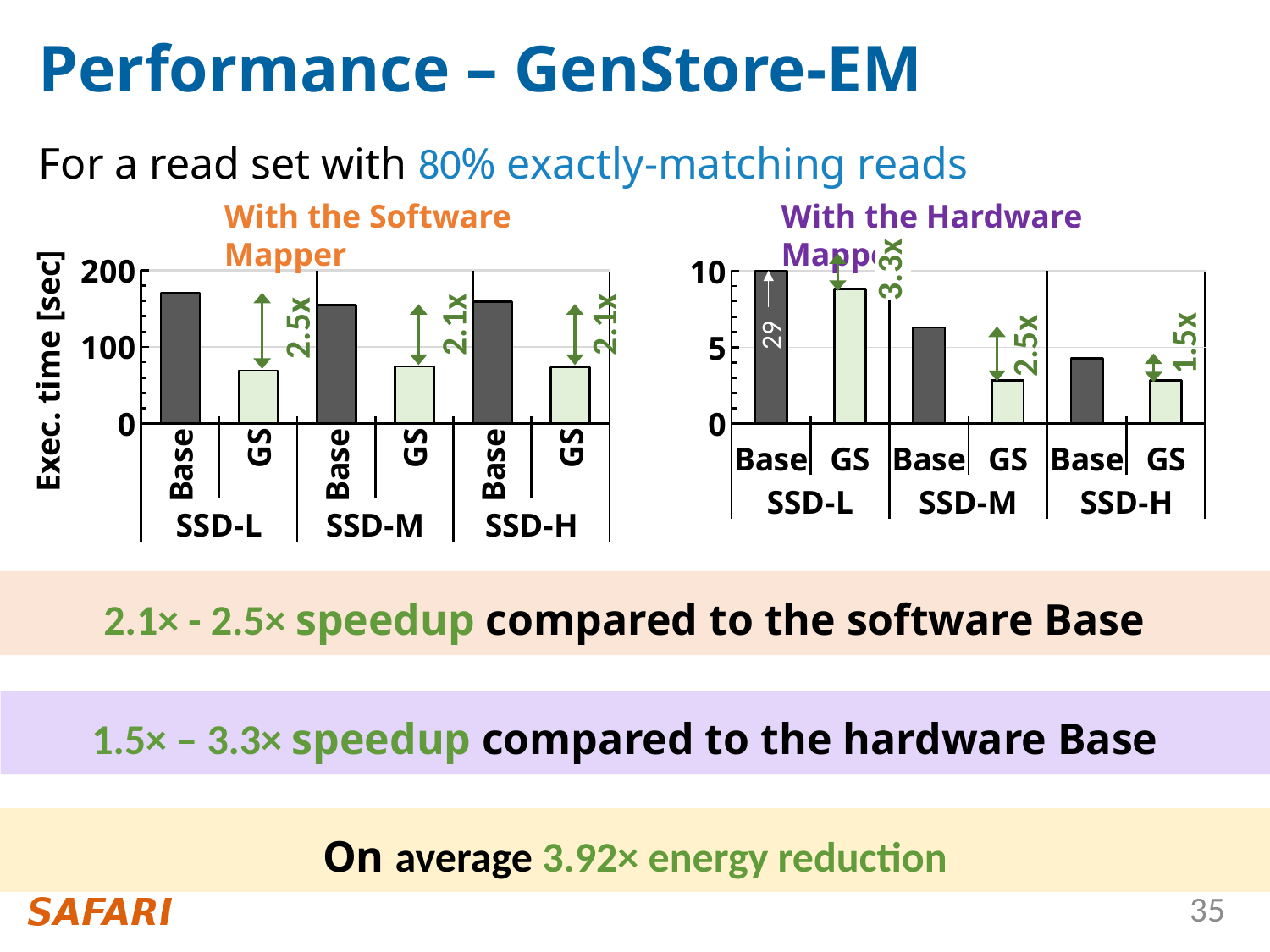
What kind of chart is the 'With the Software Mapper' chart? bar chart In the 'With the Software Mapper' chart, what speedup is annotated for SSD-M? 2.1x In the 'With the Software Mapper' chart, is the GS execution time for SSD-M greater or less than 100? less In the 'With the Hardware Mapper' chart, what value is printed on the Base bar for SSD-L? 29 In the 'With the Hardware Mapper' chart, what speedup is annotated for SSD-L? 3.3x How many bars are plotted in the 'With the Hardware Mapper' chart? 6 In the 'With the Hardware Mapper' chart, what speedup is annotated for SSD-H? 1.5x In the 'With the Software Mapper' chart, is the Base execution time for SSD-L greater or less than 100? greater In the 'With the Hardware Mapper' chart, which SSD configuration has the highest Base execution time? SSD-L In the 'With the Software Mapper' chart, what speedup is annotated for SSD-L? 2.5x In the 'With the Software Mapper' chart, which is larger for SSD-H: the Base bar or the GS bar? Base In the 'With the Hardware Mapper' chart, is the GS execution time for SSD-H greater or less than 5? less